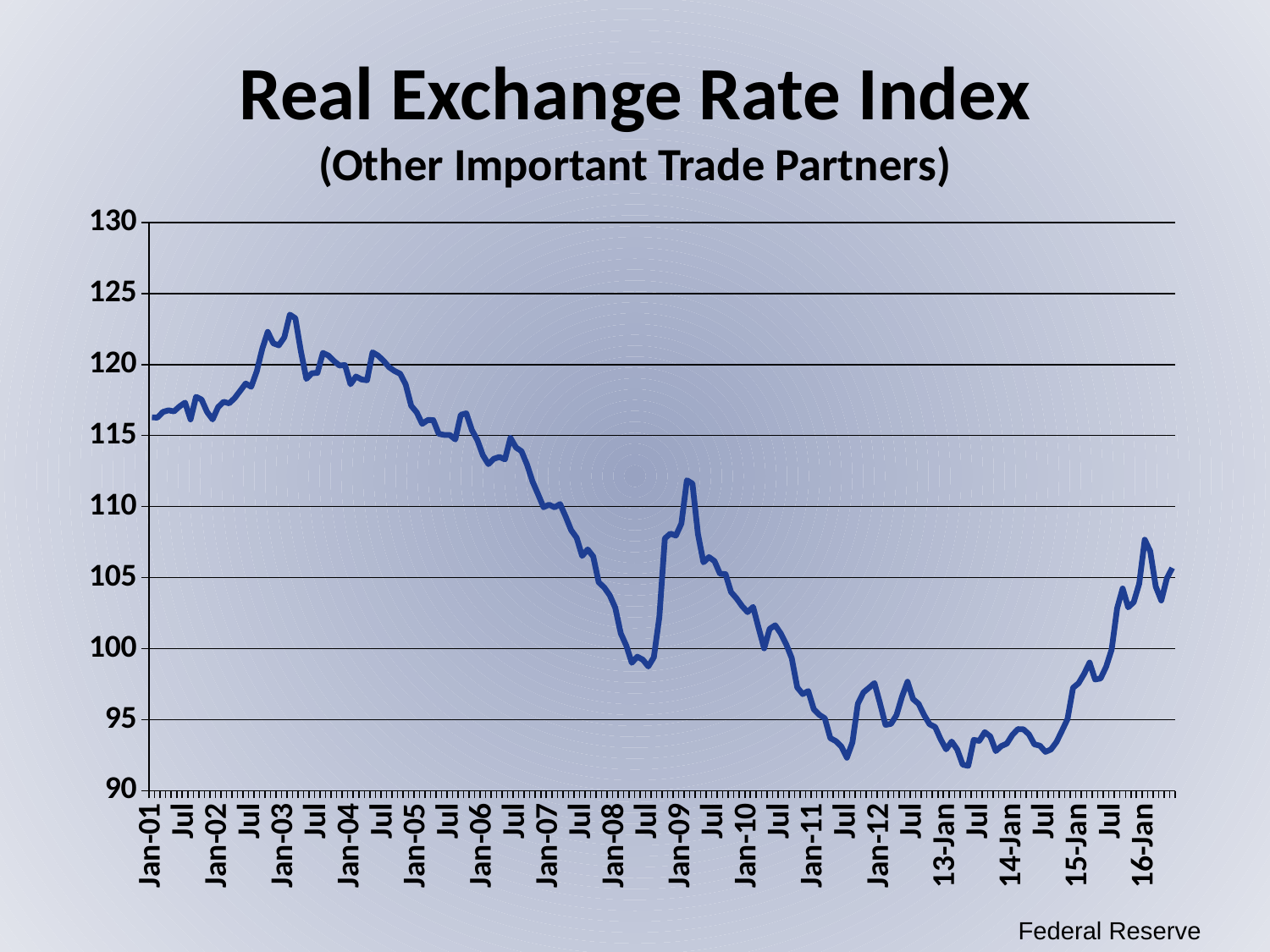
Around which x-axis label does the index reach its highest point? Jan-03 Is the value at 13-Jan greater or less than 95? less Is the value at 16-Jan greater or less than 105? greater Is the value at Jul-11 greater or less than 95? less What source is cited at the bottom of the slide? Federal Reserve Which is higher, the value at Jan-01 or the value at 16-Jan? Jan-01 Does the index generally rise or fall between Jan-03 and Jul-08? fall What kind of chart is shown on the slide? line chart What is the title of the chart? Real Exchange Rate Index (Other Important Trade Partners) Around which x-axis label does the index reach its lowest point? Jul (2013), between 13-Jan and 14-Jan